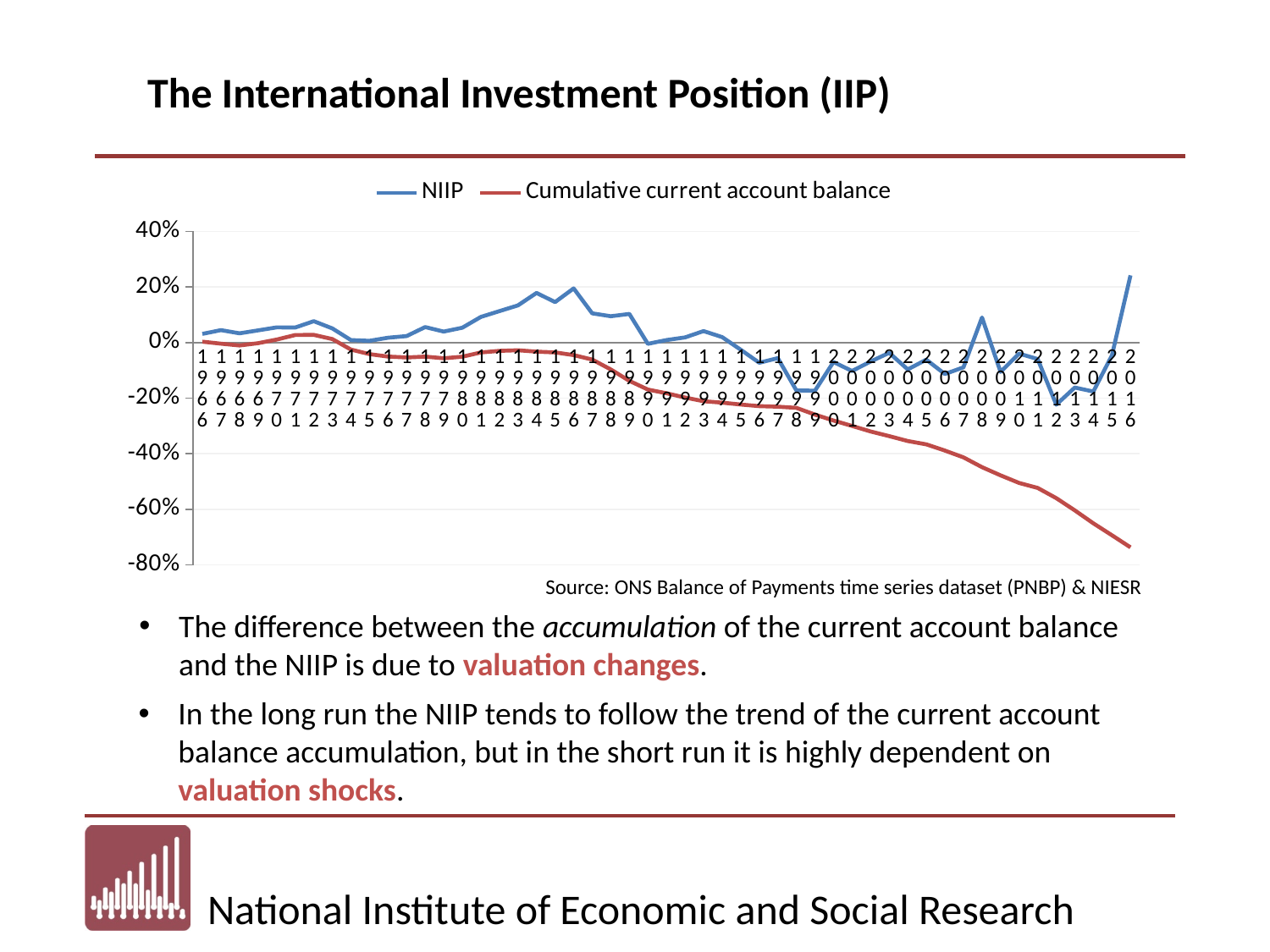
What kind of chart is shown on the slide? Line chart Is the value of the Cumulative current account balance in 2016 greater or less than -60%? less How many series does the legend list? 2 Which series is drawn in red? Cumulative current account balance Is the value of the Cumulative current account balance in 2012 greater or less than -40%? less In 2016, which series has the higher value, NIIP or Cumulative current account balance? NIIP In which year does NIIP reach its highest value? 2016 Does the Cumulative current account balance rise or fall overall from 1966 to 2016? Fall Is the value of NIIP in 2016 greater or less than 20%? greater What are the two series named in the legend? NIIP and Cumulative current account balance In which year does the Cumulative current account balance reach its lowest value? 2016